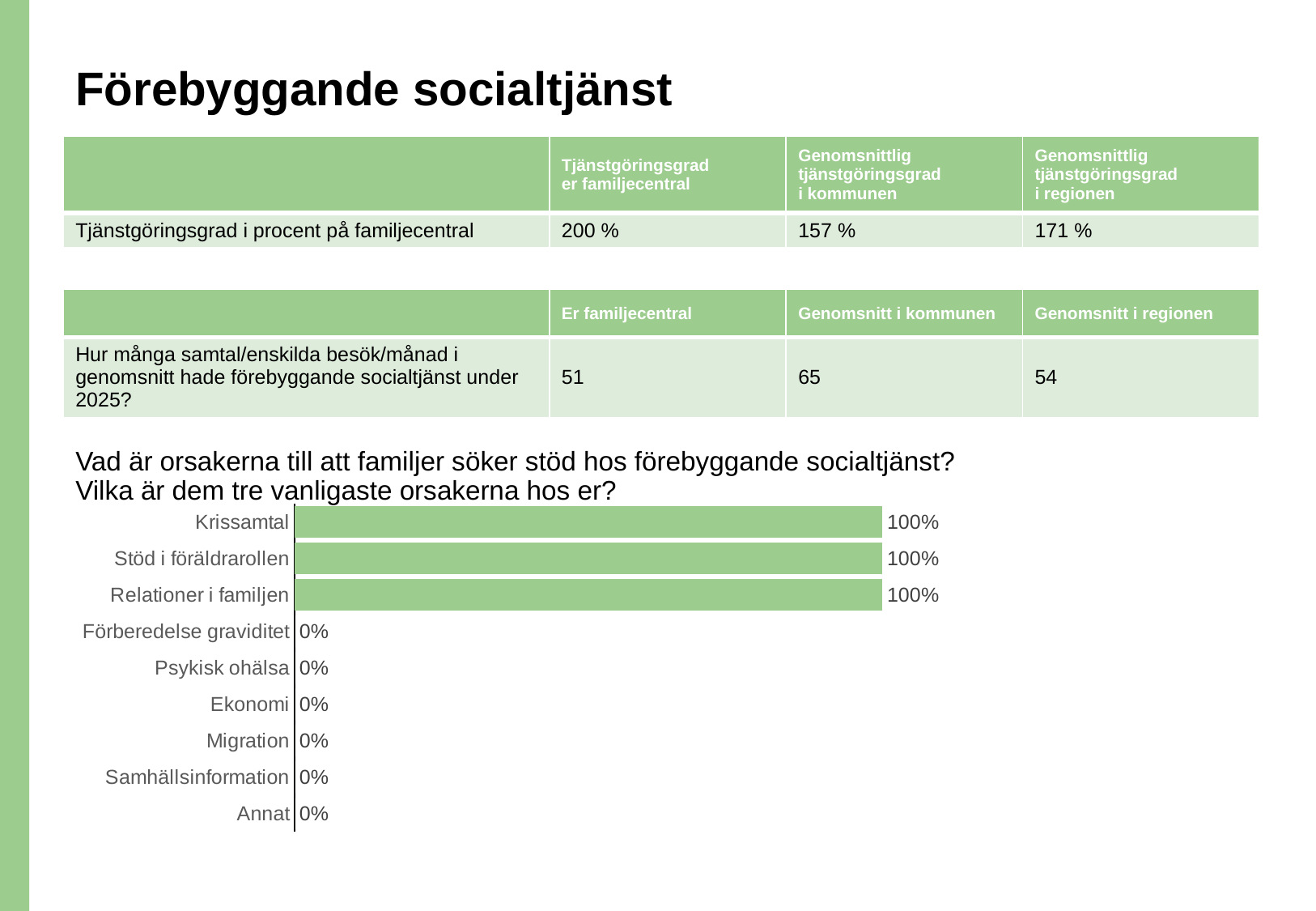
How many categories are shown in the bar chart? 9 What is the difference between the value for Relationer i familjen and the value for Samhällsinformation in the bar chart? 100% What is the value for Stöd i föräldrarollen in the bar chart? 100% What is the value for Krissamtal in the bar chart? 100% What is the value for Relationer i familjen in the bar chart? 100% What is the value for Psykisk ohälsa in the bar chart? 0% Which is larger in the bar chart, the value for Krissamtal or the value for Migration? Krissamtal What is the value for Annat in the bar chart? 0% What kind of chart is shown on the slide? Bar chart How many categories in the bar chart have a value of 100%? 3 Which category is listed first (at the top) of the bar chart? Krissamtal What is the value for Ekonomi in the bar chart? 0%